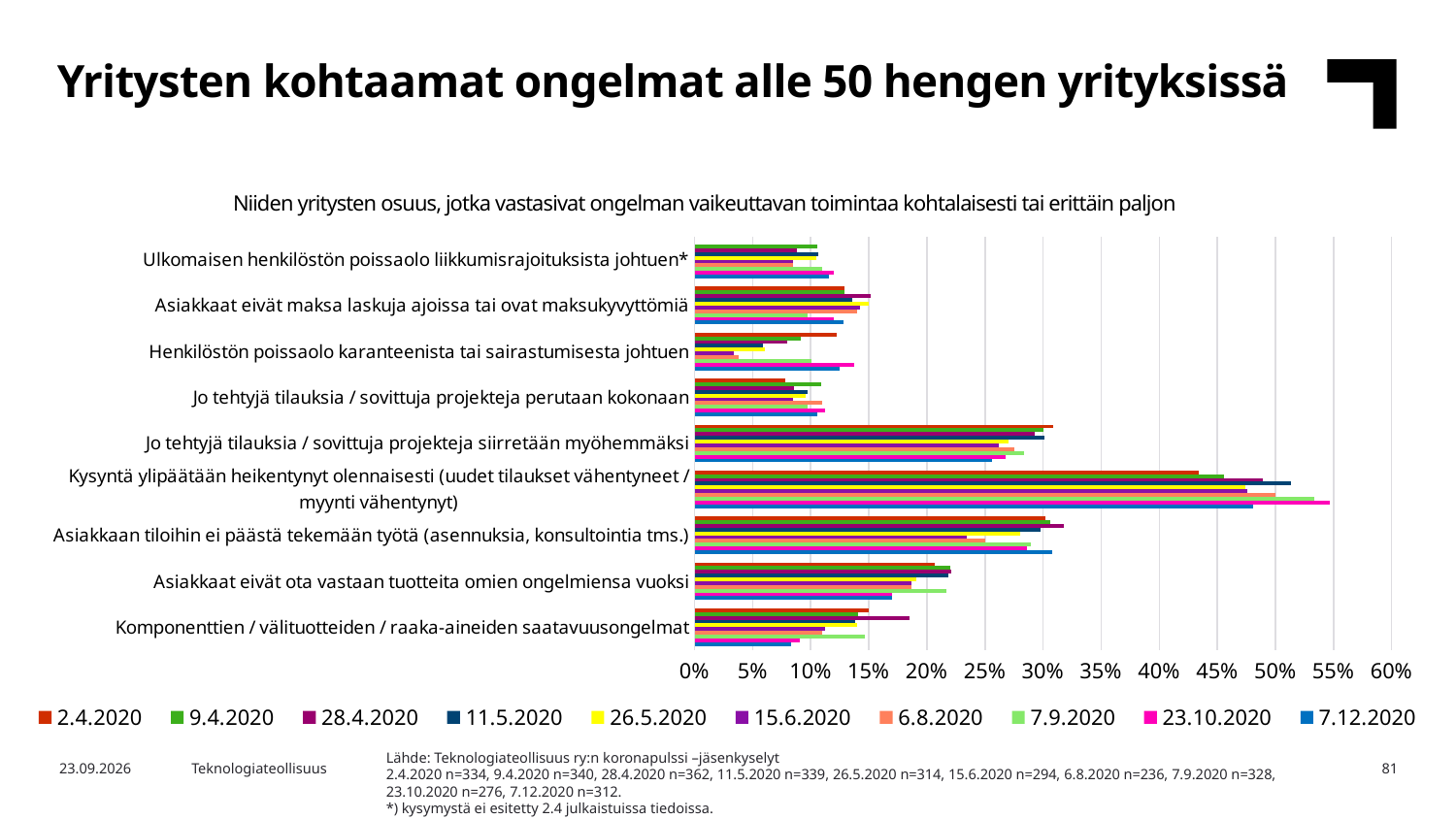
What kind of chart is shown on the slide? bar chart Is the value for 'Jo tehtyjä tilauksia / sovittuja projekteja siirretään myöhemmäksi' on 2.4.2020 greater or less than 25%? greater How many series (survey dates) does the legend list? 10 Which is larger on 2.4.2020: the value for 'Kysyntä ylipäätään heikentynyt olennaisesti' or for 'Komponenttien / välituotteiden / raaka-aineiden saatavuusongelmat'? Kysyntä ylipäätään heikentynyt olennaisesti Which category has the highest values across the survey dates? Kysyntä ylipäätään heikentynyt olennaisesti (uudet tilaukset vähentyneet / myynti vähentynyt) Is the value for 'Komponenttien / välituotteiden / raaka-aineiden saatavuusongelmat' on 7.12.2020 greater or less than 10%? less How many categories (problem types) are listed on the chart's vertical axis? 9 Is the value for 'Asiakkaan tiloihin ei päästä tekemään työtä' on 2.4.2020 greater or less than 25%? greater What is the first survey date listed in the legend? 2.4.2020 What is the highest value shown on the horizontal axis? 60%